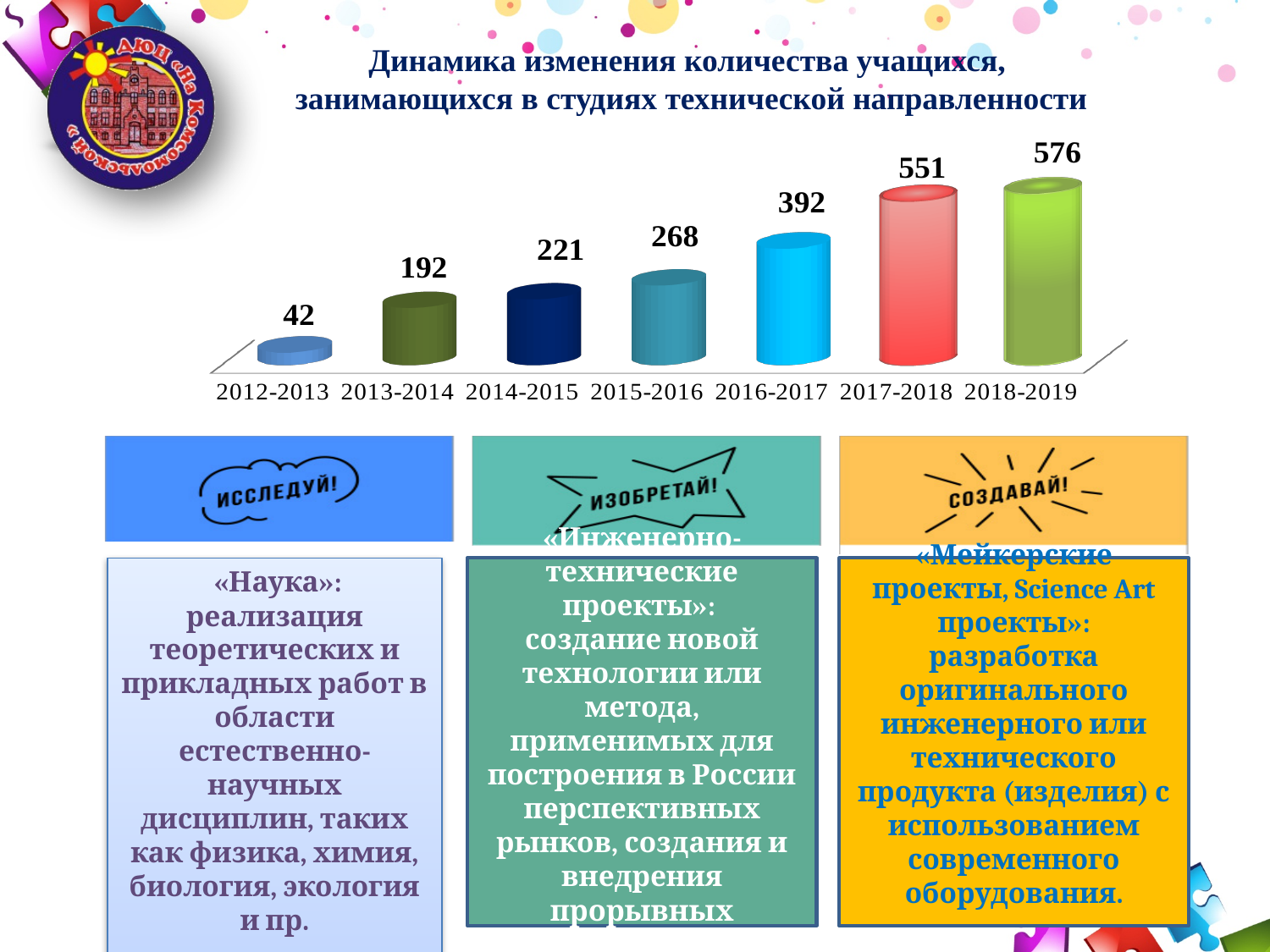
Do the values rise or fall from 2012-2013 to 2018-2019? rise Which is larger, the value for 2014-2015 or the value for 2015-2016? 2015-2016 What is the value for 2016-2017? 392 How many categories (school years) are shown on the chart? 7 What is the title of the chart? Динамика изменения количества учащихся, занимающихся в студиях технической направленности What is the difference between the values for 2017-2018 and 2016-2017? 159 Which year has the lowest value? 2012-2013 What is the value for 2012-2013? 42 What is the value for 2018-2019? 576 What is the difference between the values for 2013-2014 and 2012-2013? 150 What kind of chart is shown on the slide? bar chart Which year has the highest value? 2018-2019